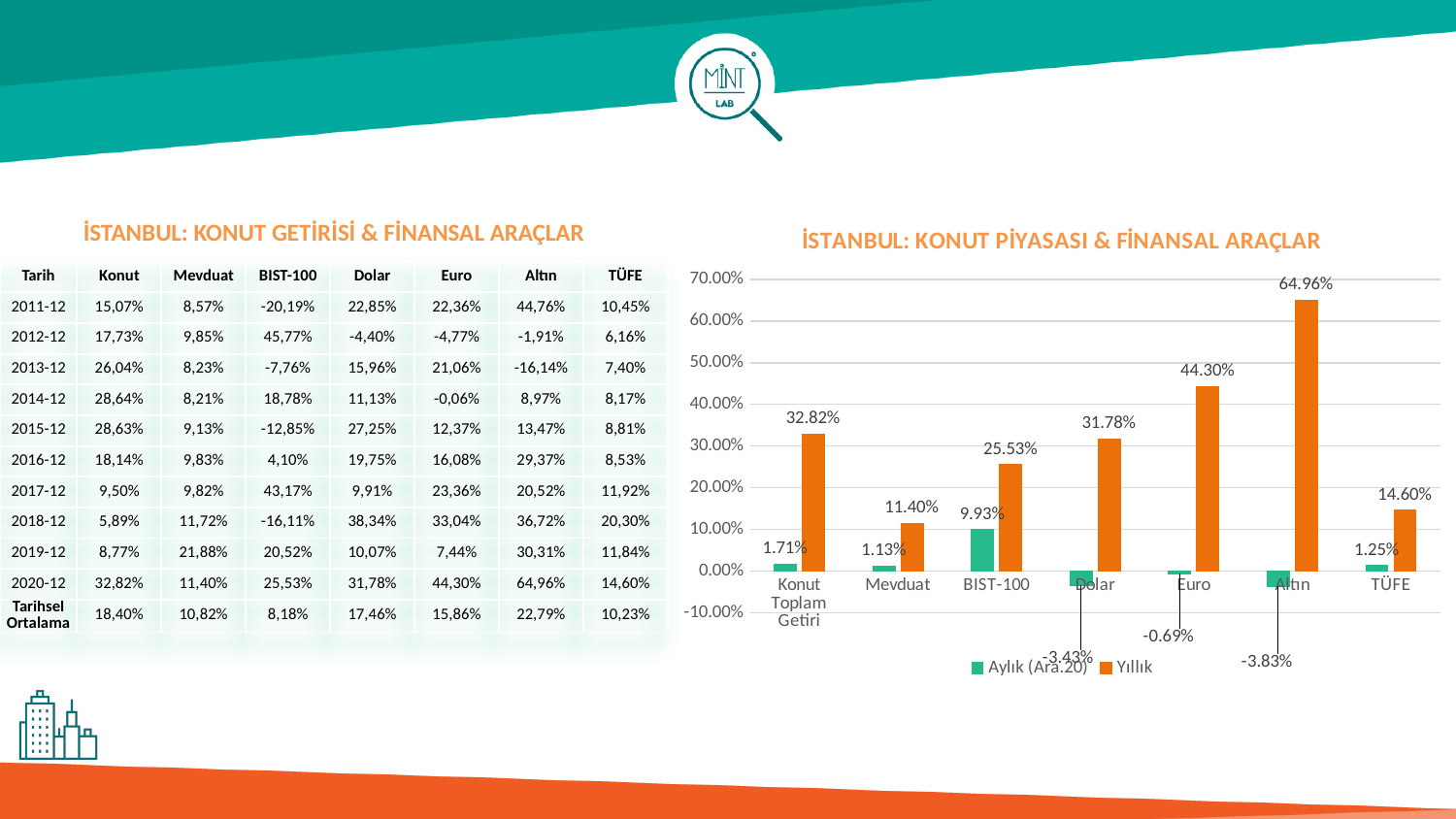
Which is larger, the Yıllık value for Konut Toplam Getiri or for BIST-100? Konut Toplam Getiri Which category has the highest Yıllık value? Altın Which category has the lowest Aylık (Ara.20) value? Altın What is the Aylık (Ara.20) value for BIST-100? 9.93% What type of chart is shown on the slide? bar chart What is the Aylık (Ara.20) value for Dolar? -3.43% What is the difference between the Yıllık values for Euro and Dolar? 12.52% How many series does the chart legend list? 2 What is the Yıllık value for Altın? 64.96% How many categories are shown on the x axis of the chart? 7 What is the Yıllık value for Konut Toplam Getiri? 32.82% Which category has the lowest Yıllık value? Mevduat